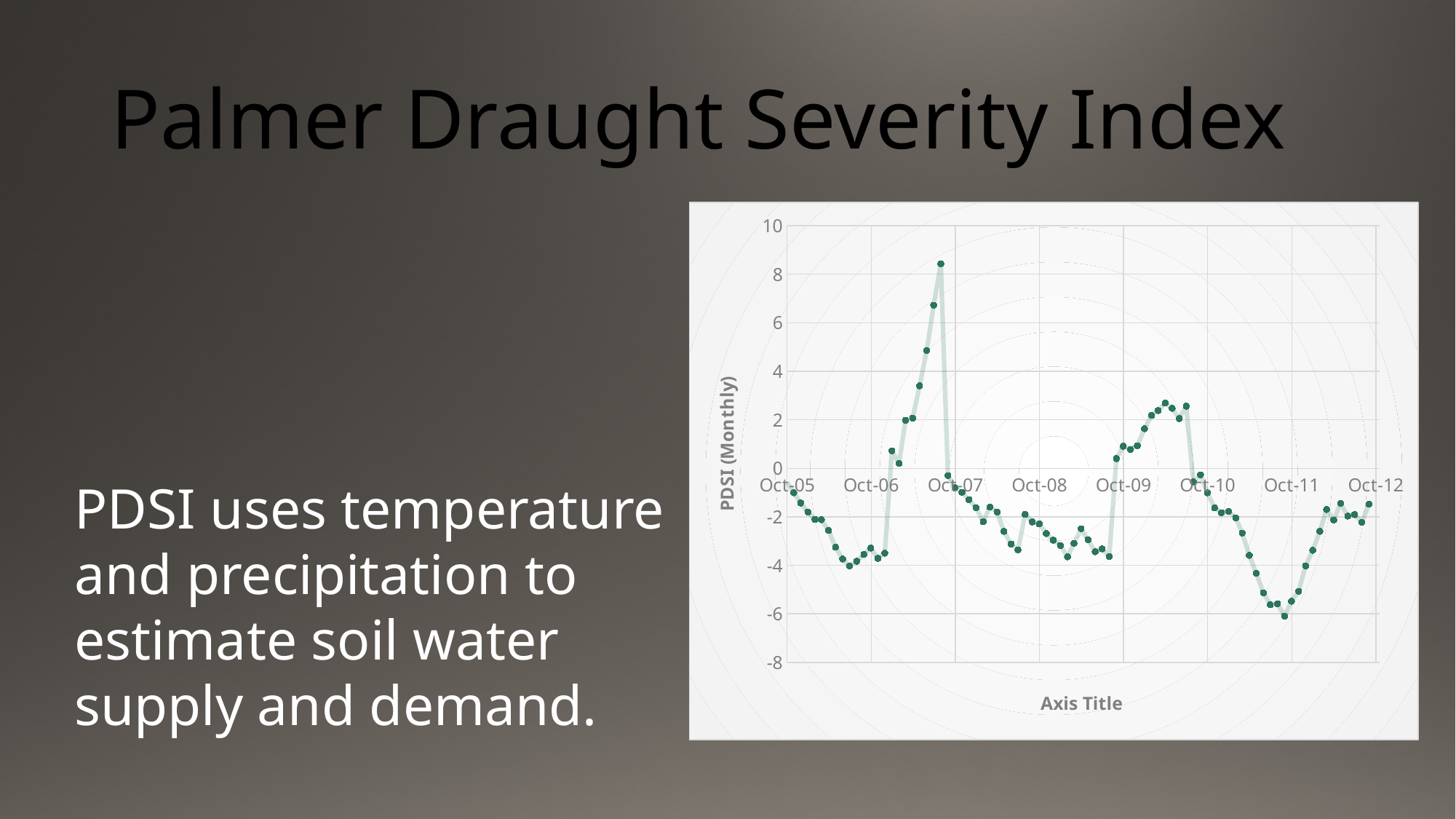
Near which horizontal-axis label does the line reach its lowest value? Oct-11 Is the PDSI value at Oct-05 greater or less than 0? less What is the title of the vertical axis of the chart? PDSI (Monthly) How many labels are shown on the horizontal axis of the chart? 8 Is the PDSI value at Oct-12 greater or less than 0? less Is the highest PDSI value on the chart greater or less than 8? greater Between Oct-10 and Oct-11, do the PDSI values generally rise or fall? fall Near which horizontal-axis label does the line reach its highest value? Oct-07 What kind of chart is shown on the slide? line chart What is the title shown under the horizontal axis of the chart? Axis Title